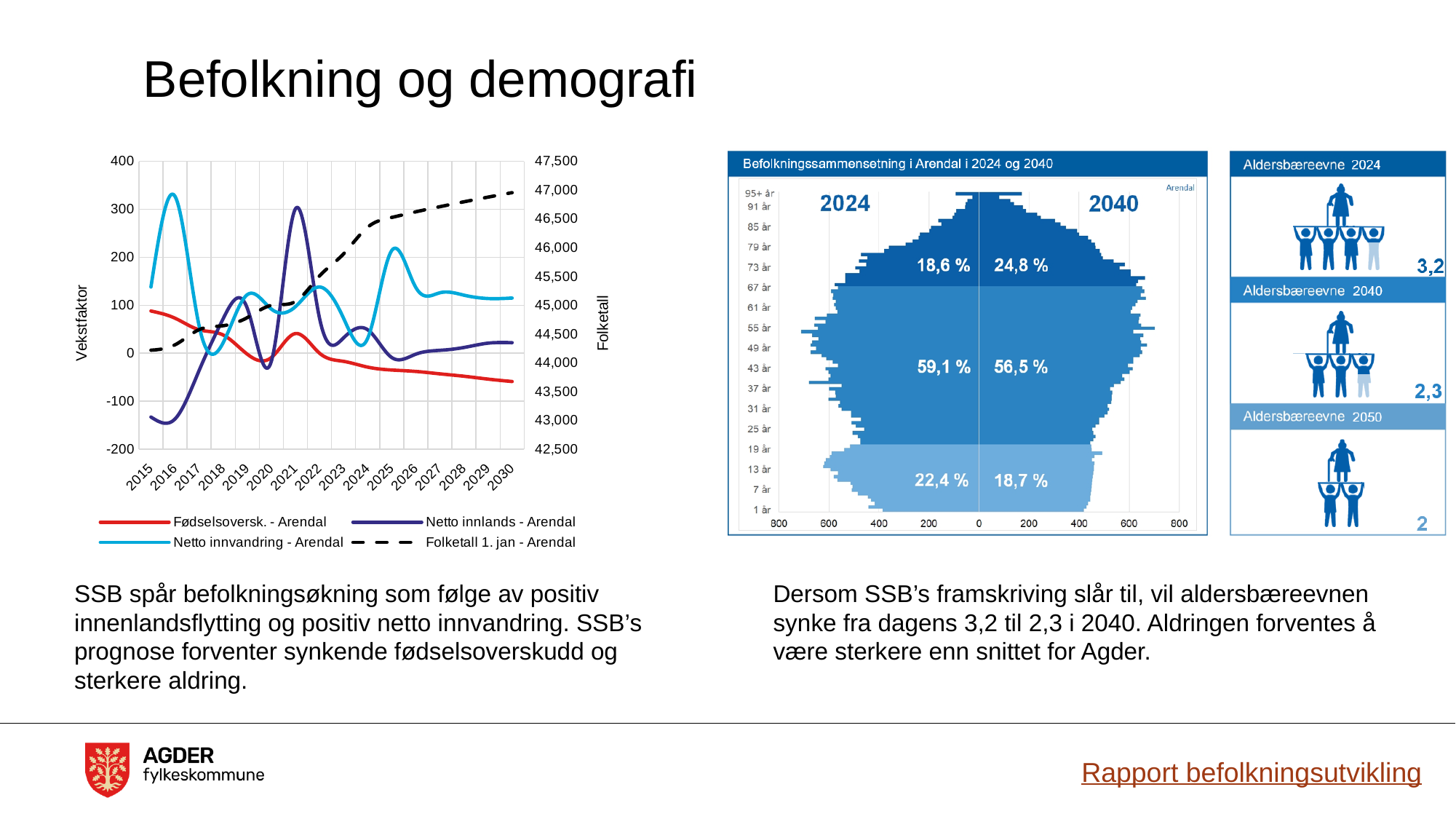
In the left-hand line chart, is the value for Netto innvandring - Arendal in 2016 greater or less than 300? greater In the left-hand line chart, does the Folketall 1. jan - Arendal series rise or fall from 2015 to 2030? Rise In the left-hand line chart, is the Folketall 1. jan - Arendal value in 2030 greater or less than 46,500? greater How many series does the legend of the left-hand line chart list? 4 In the Aldersbæreevne panel on the right, what is the value for 2040? 2,3 In the chart 'Befolkningssammensetning i Arendal i 2024 og 2040', by how many percentage points does the share of the oldest age group increase from 2024 to 2040? 6,2 In the chart 'Befolkningssammensetning i Arendal i 2024 og 2040', what share of the population is in the oldest age group (67 år and above) in 2024? 18,6 % What kind of chart is the left-hand chart with the Vekstfaktor axis? Line chart In the left-hand line chart, is the value for Fødselsoversk. - Arendal in 2030 greater or less than 0? less In the chart 'Befolkningssammensetning i Arendal i 2024 og 2040', what share of the population is in the middle age group in 2040? 56,5 % How many years are shown on the x axis of the left-hand line chart? 16 In the chart 'Befolkningssammensetning i Arendal i 2024 og 2040', which year has the larger share in the youngest age group, 2024 or 2040? 2024